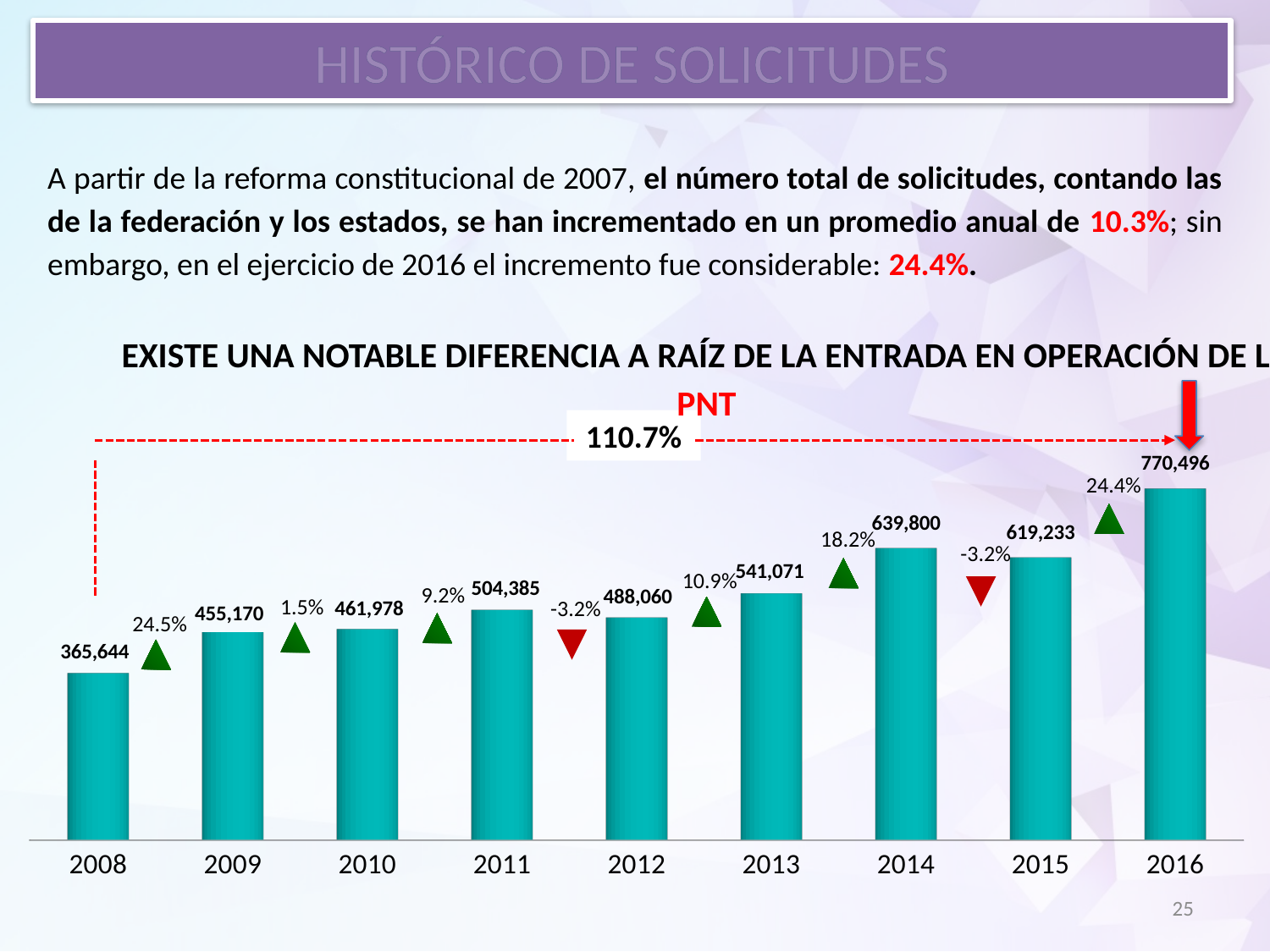
Which year has the highest value? 2016 Which is larger, the value for 2014 or the value for 2015? 2014 What overall percentage change is shown between 2008 and 2016 by the dashed line? 110.7% What is the difference between the values for 2009 and 2008? 89,526 How many years are shown on the x axis? 9 What is the value for 2008? 365,644 What is the value for 2012? 488,060 What is the difference between the values for 2016 and 2015? 151,263 What percentage change is shown between 2015 and 2016? 24.4% Which year has the lowest value? 2008 What is the value for 2016? 770,496 What kind of chart is shown? Bar chart